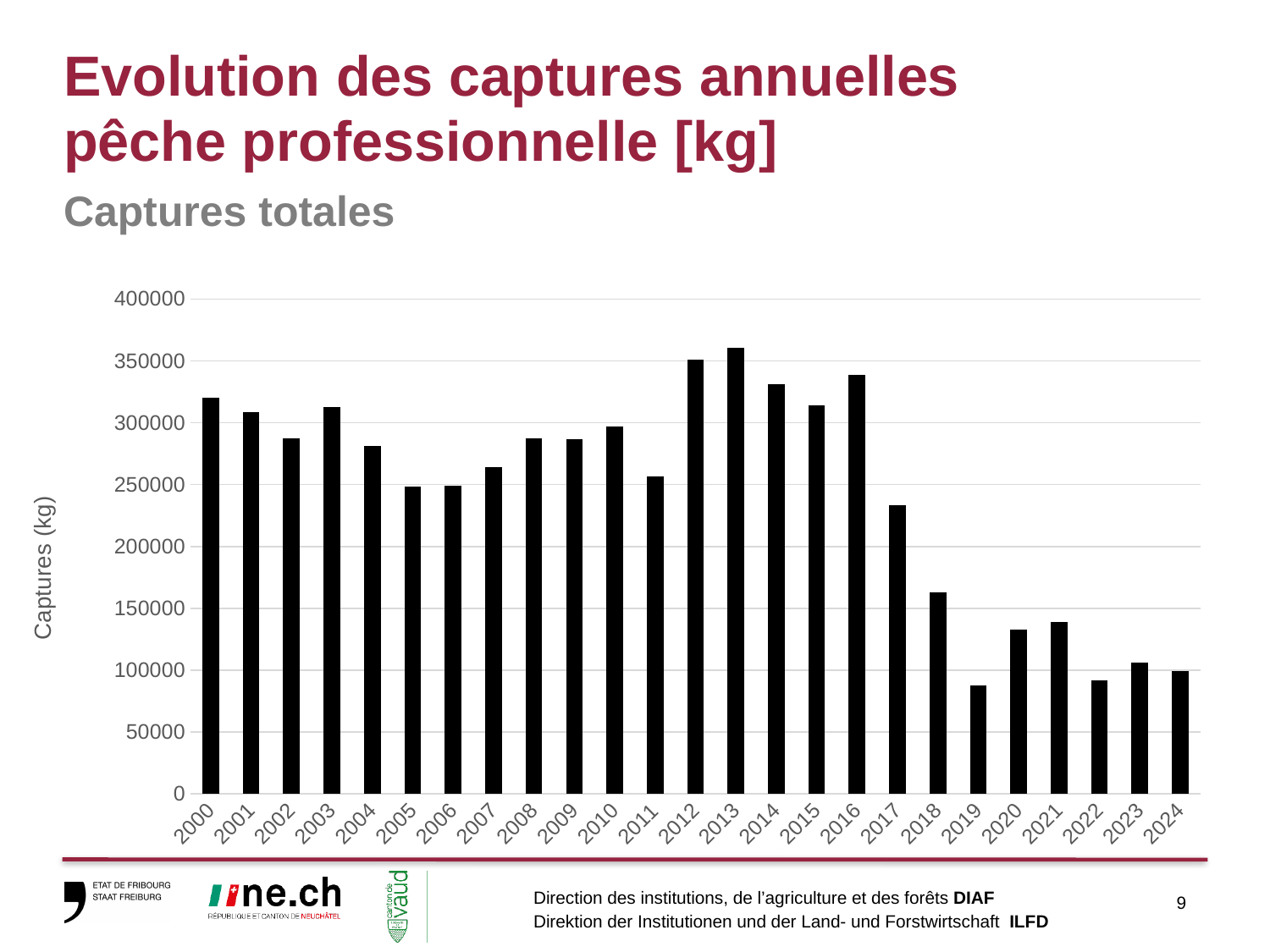
Is the value for 2017 greater or less than 250000? less Is the value for 2020 greater or less than 100000? greater Is the value for 2019 greater or less than 100000? less Which year has the larger total catch, 2015 or 2016? 2016 Which year has the larger total catch, 2000 or 2024? 2000 Do the values rise or fall from 2016 to 2019? fall What kind of chart is shown on the slide? bar chart What is the label on the y axis of the chart? Captures (kg) How many years are plotted on the x axis of the chart? 25 Which year has the highest total catch in the chart? 2013